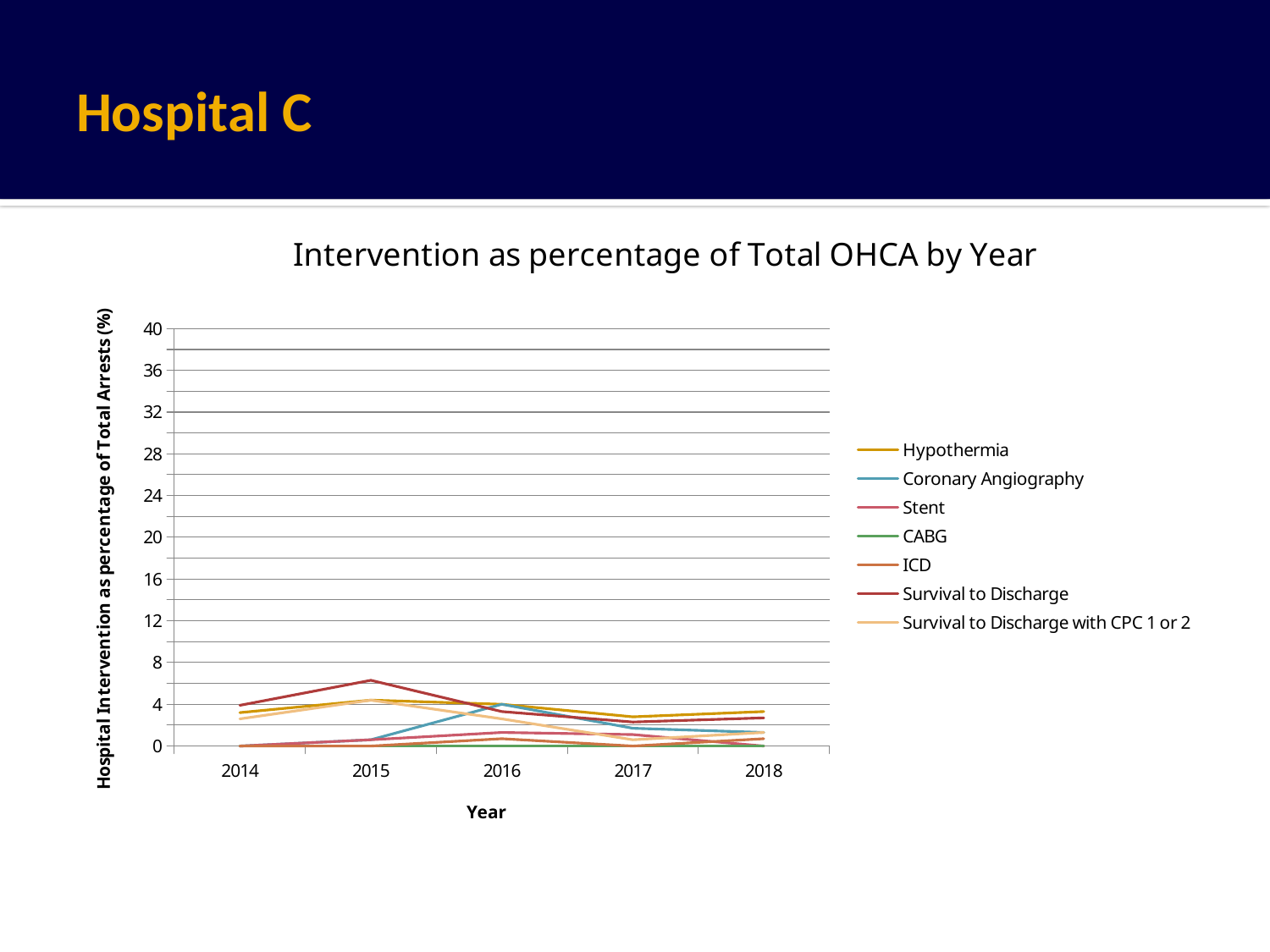
Does the Survival to Discharge line rise or fall from 2015 to 2018? fall Which series has the highest value in 2015? Survival to Discharge How many series does the legend list? 7 Is the value for Survival to Discharge in 2015 greater or less than 4? greater How many years are plotted along the x axis? 5 What is the title of the chart? Intervention as percentage of Total OHCA by Year In which year does the Survival to Discharge line reach its highest value? 2015 What is the label of the vertical axis? Hospital Intervention as percentage of Total Arrests (%) Does the Coronary Angiography line rise or fall from 2014 to 2016? rise Is the value for CABG in 2016 greater or less than 4? less Is the value for Coronary Angiography in 2014 greater or less than 4? less What kind of chart is shown on the slide? line chart